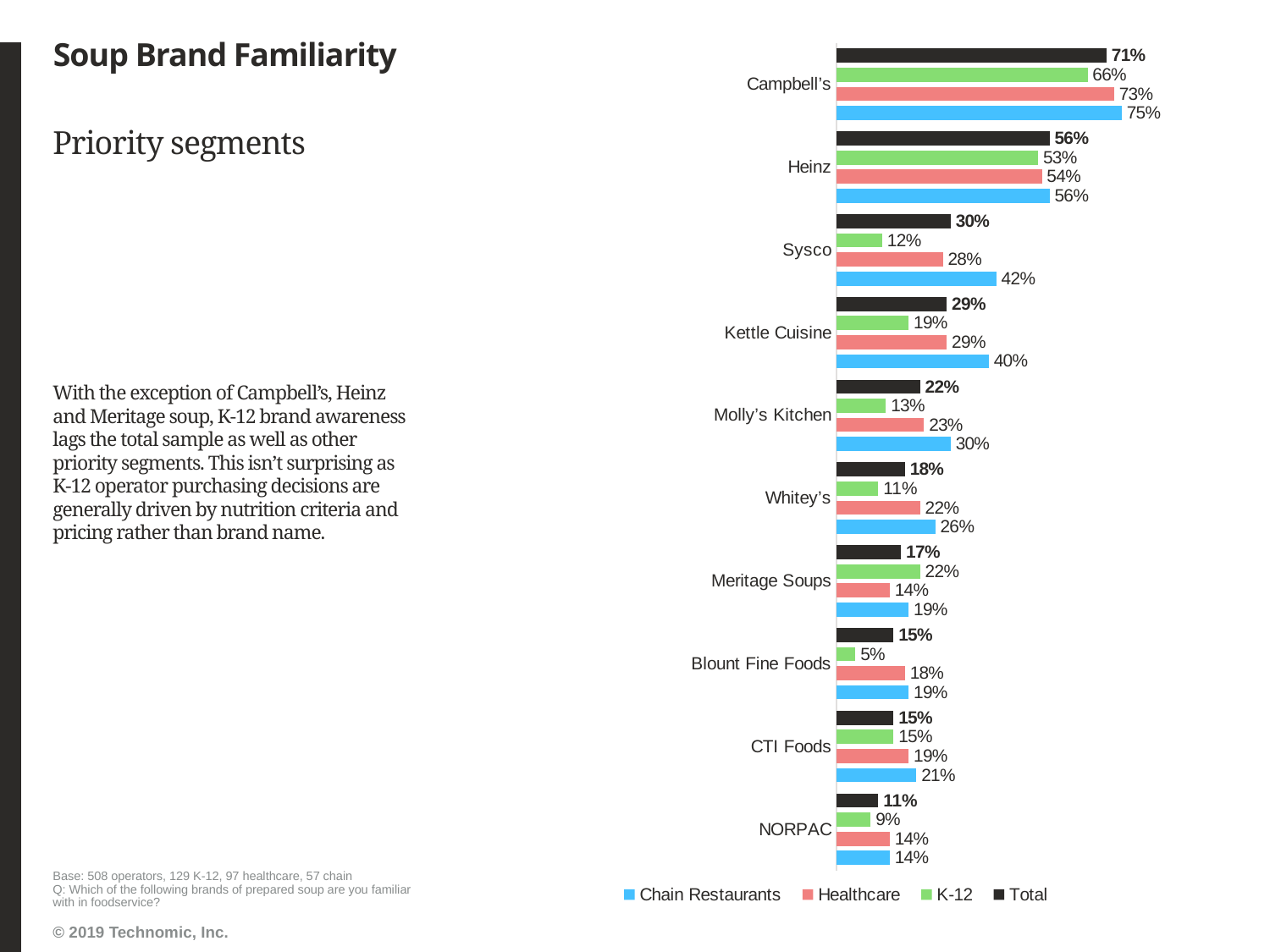
Which brand has the lowest K-12 familiarity? Blount Fine Foods For Meritage Soups, which is larger: the K-12 value or the Chain Restaurants value? K-12 What is the difference between the Chain Restaurants and K-12 values for Sysco? 30% How many series does the legend list? 4 What is the Total value for Campbell's? 71% What is the Healthcare value for Meritage Soups? 14% What is the K-12 value for Sysco? 12% What kind of chart is shown on the slide? Bar chart Which colour represents the Healthcare series in the chart? Red How many brands are shown on the chart? 10 What is the Chain Restaurants value for Kettle Cuisine? 40% Which brand has the highest Total familiarity? Campbell's